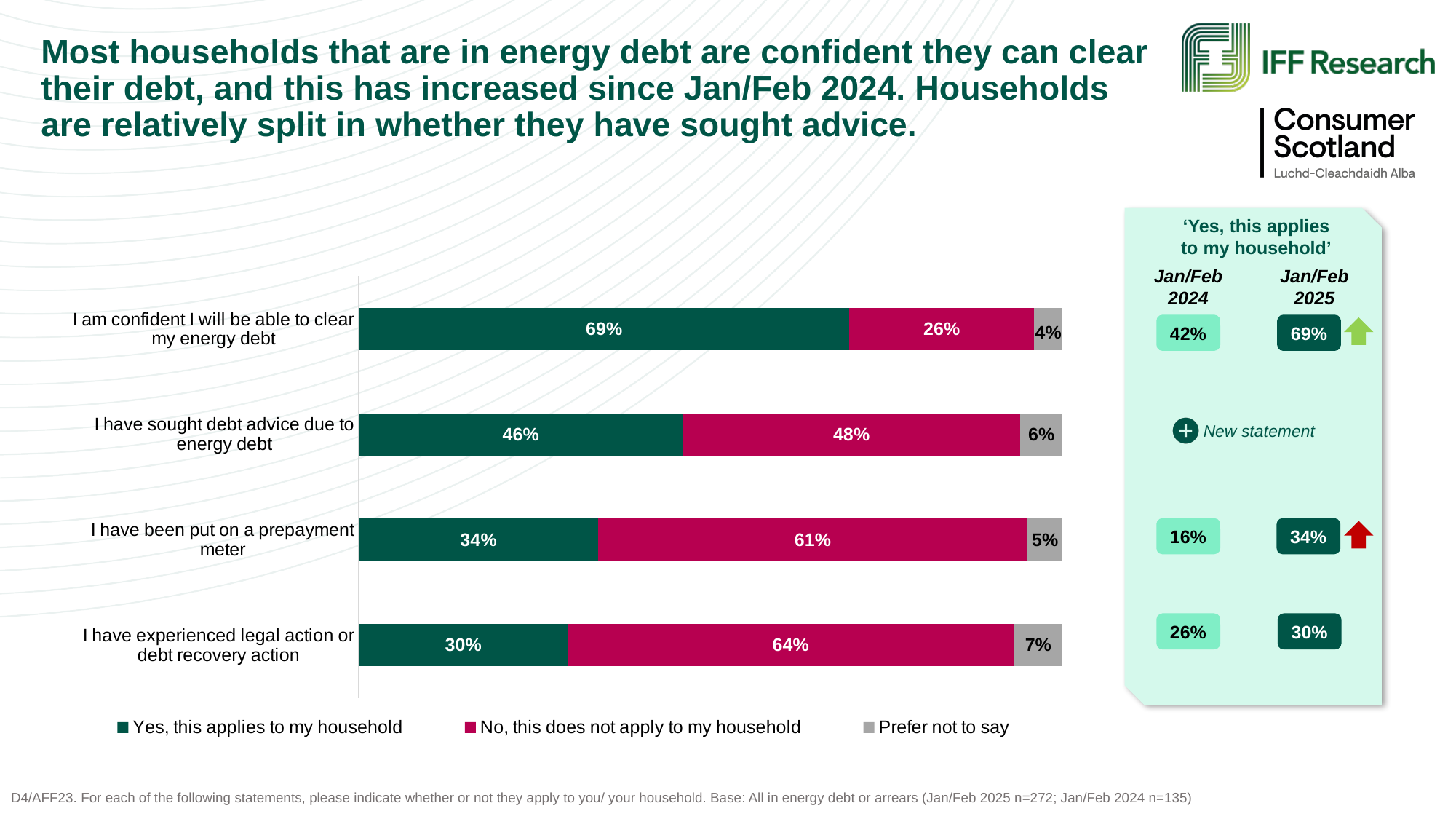
What percentage of households answered 'Prefer not to say' for 'I have experienced legal action or debt recovery action'? 7% For 'I have been put on a prepayment meter', which is larger: the 'Yes' share or the 'No' share? No, this does not apply to my household What percentage of households say 'Yes, this applies to my household' for 'I am confident I will be able to clear my energy debt'? 69% Which statement has the highest 'Yes, this applies to my household' percentage? I am confident I will be able to clear my energy debt What is the difference between the 'Yes' and 'No' percentages for 'I have sought debt advice due to energy debt'? 2 percentage points What percentage of households say 'No, this does not apply to my household' for 'I have been put on a prepayment meter'? 61% How many statements are shown in the bar chart? 4 In the side panel, what was the Jan/Feb 2024 'Yes' percentage for 'I have been put on a prepayment meter'? 16% How many series does the legend list? 3 Which statement has the lowest 'Yes, this applies to my household' percentage? I have experienced legal action or debt recovery action What type of chart is used on this slide? Stacked bar chart Which statement is marked as a 'New statement' in the side panel? I have sought debt advice due to energy debt